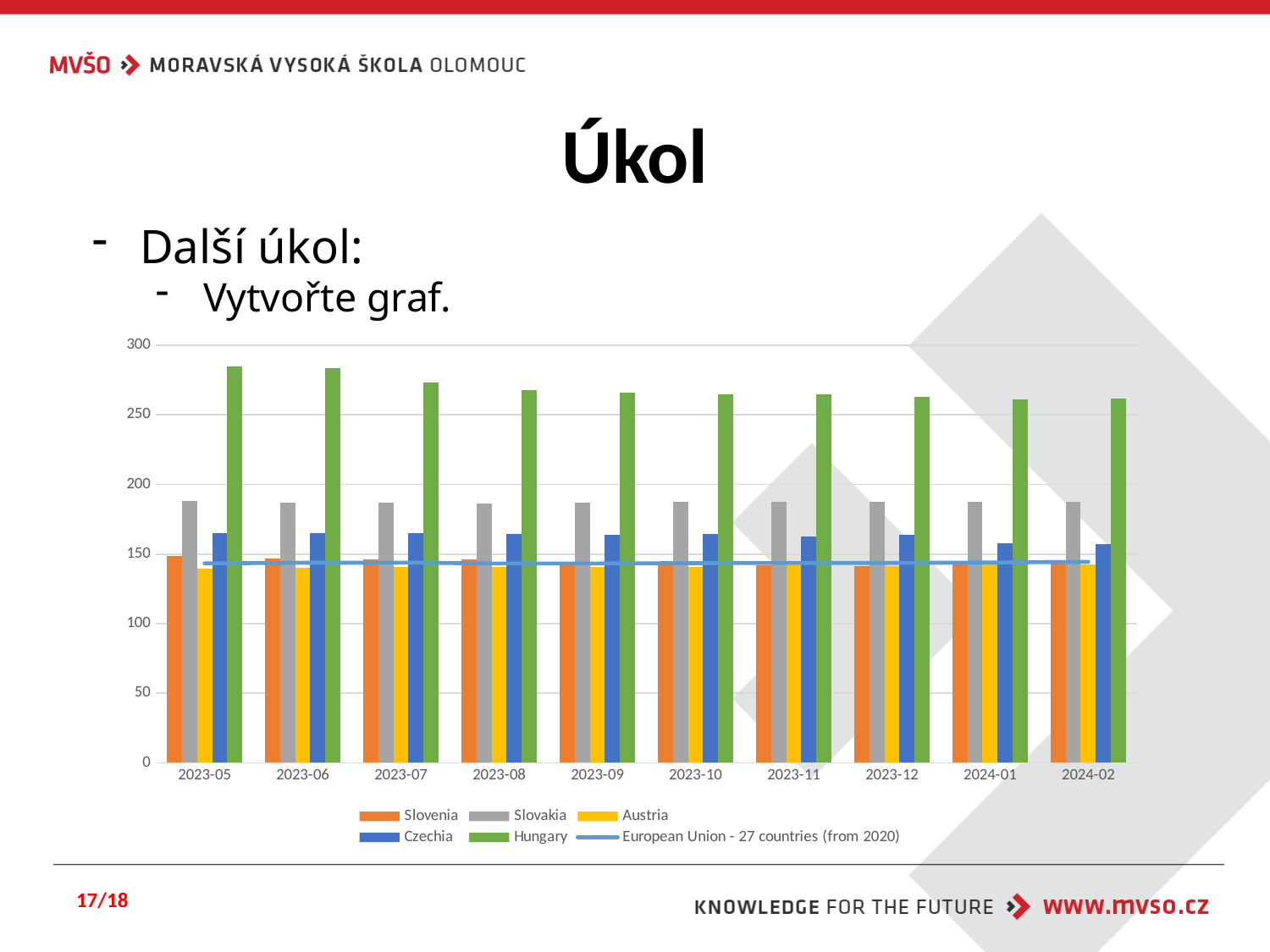
Is the value for Slovakia in 2023-10 greater or less than 200? less Which series in the legend is drawn as a line rather than bars? European Union - 27 countries (from 2020) How many series does the chart's legend list? 6 Do the values for Hungary rise or fall from 2023-05 to 2024-02? fall Is the value for Czechia in 2023-06 greater or less than 150? greater Which country has the highest bar in 2023-05? Hungary What kind of chart is shown on the slide? bar chart (with a line series) Is the value for Austria in 2023-08 greater or less than 150? less Which country has the lowest bar in 2023-05? Austria In 2023-07, which is larger: the value for Slovakia or the value for Czechia? Slovakia How many months (categories) are shown on the x axis of the chart? 10